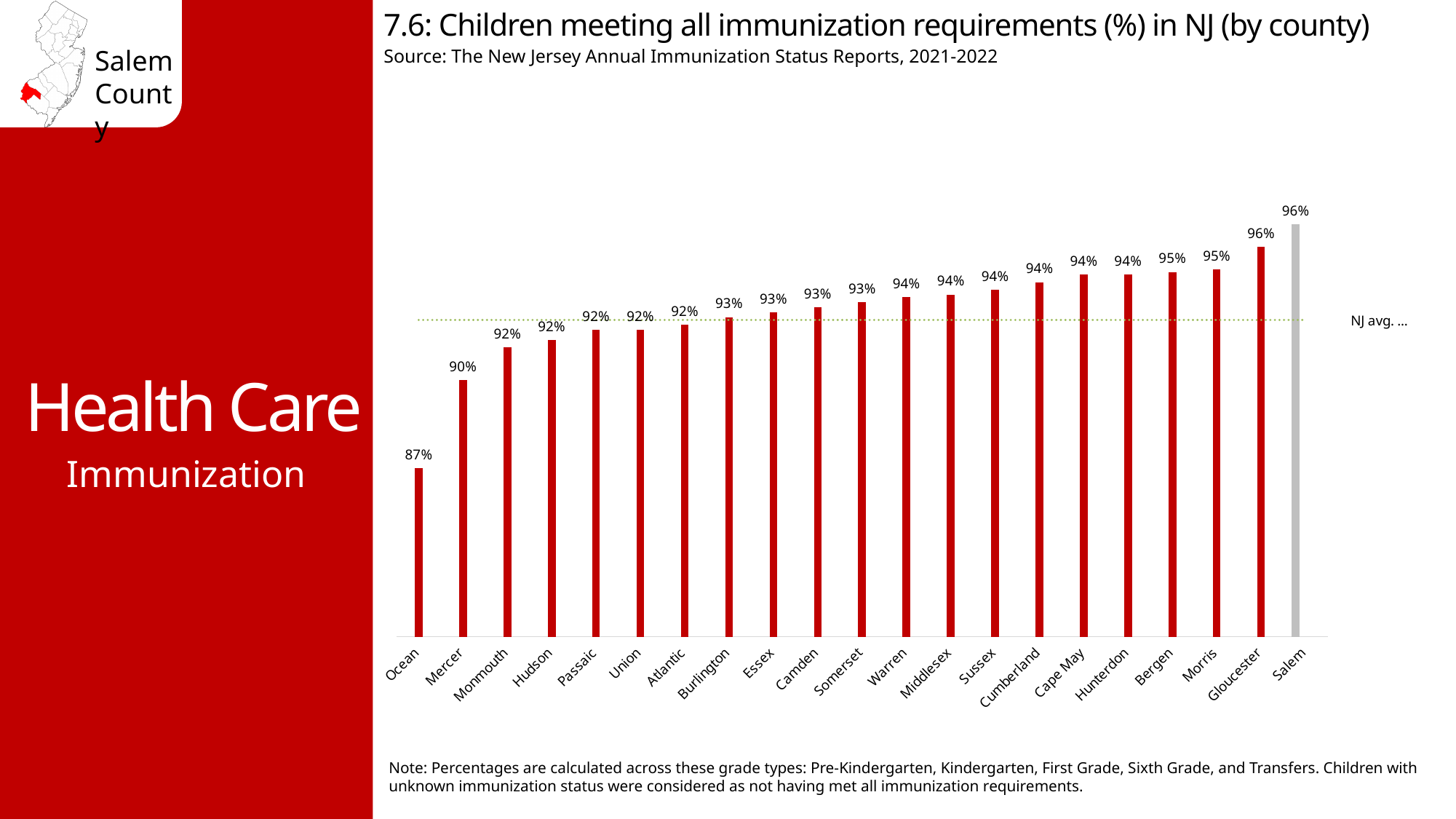
What is the difference in percentage points between Salem County and Ocean County? 9 What is the value shown for Salem County? 96% What percentage of children in Ocean County met all immunization requirements? 87% Which county has the lowest percentage of children meeting all immunization requirements? Ocean What is the difference in percentage points between Mercer County and Ocean County? 3 What kind of chart is used on this slide? Bar chart Which has a higher value, Bergen County or Monmouth County? Bergen How many counties are shown in the chart? 21 What percentage is shown for Mercer County? 90% What is the value for Bergen County? 95% Which county's bar is coloured grey instead of red? Salem Do the values generally rise or fall from left to right across the counties? Rise